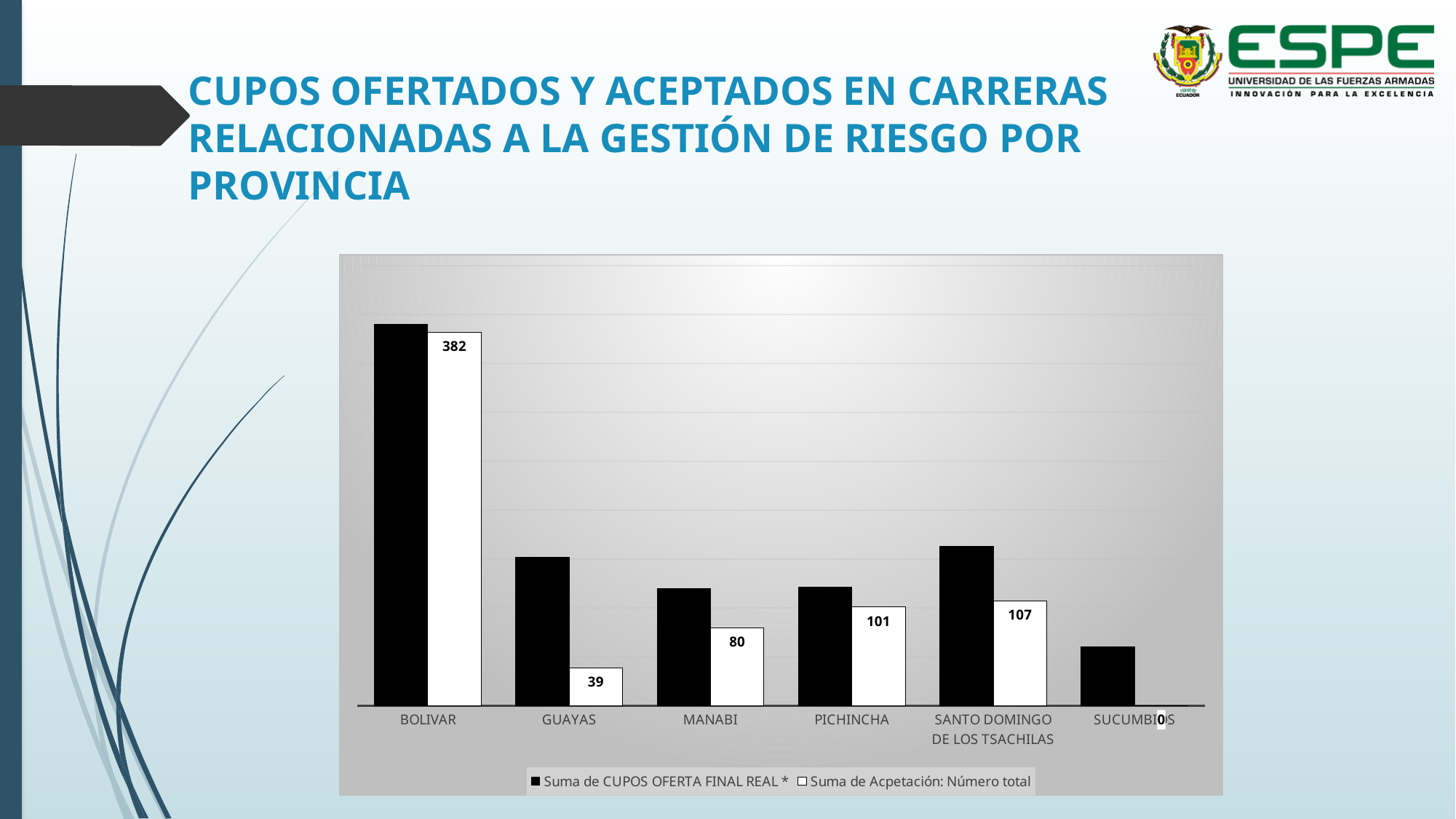
What is the value of Suma de Acpetación: Número total for BOLIVAR? 382 What type of chart is shown on the slide? Bar chart Which province has the lowest Suma de Acpetación: Número total? SUCUMBIOS What is the value of Suma de Acpetación: Número total for GUAYAS? 39 How many series does the chart legend list? 2 What is the value of Suma de Acpetación: Número total for SANTO DOMINGO DE LOS TSACHILAS? 107 How many provinces are shown on the x axis of the chart? 6 Which province has the larger Suma de Acpetación: Número total, MANABI or GUAYAS? MANABI What is the difference between the Suma de Acpetación: Número total for SANTO DOMINGO DE LOS TSACHILAS and PICHINCHA? 6 What is the value of Suma de Acpetación: Número total for MANABI? 80 Which province has the larger Suma de CUPOS OFERTA FINAL REAL *, BOLIVAR or SANTO DOMINGO DE LOS TSACHILAS? BOLIVAR Which province has the highest Suma de Acpetación: Número total? BOLIVAR